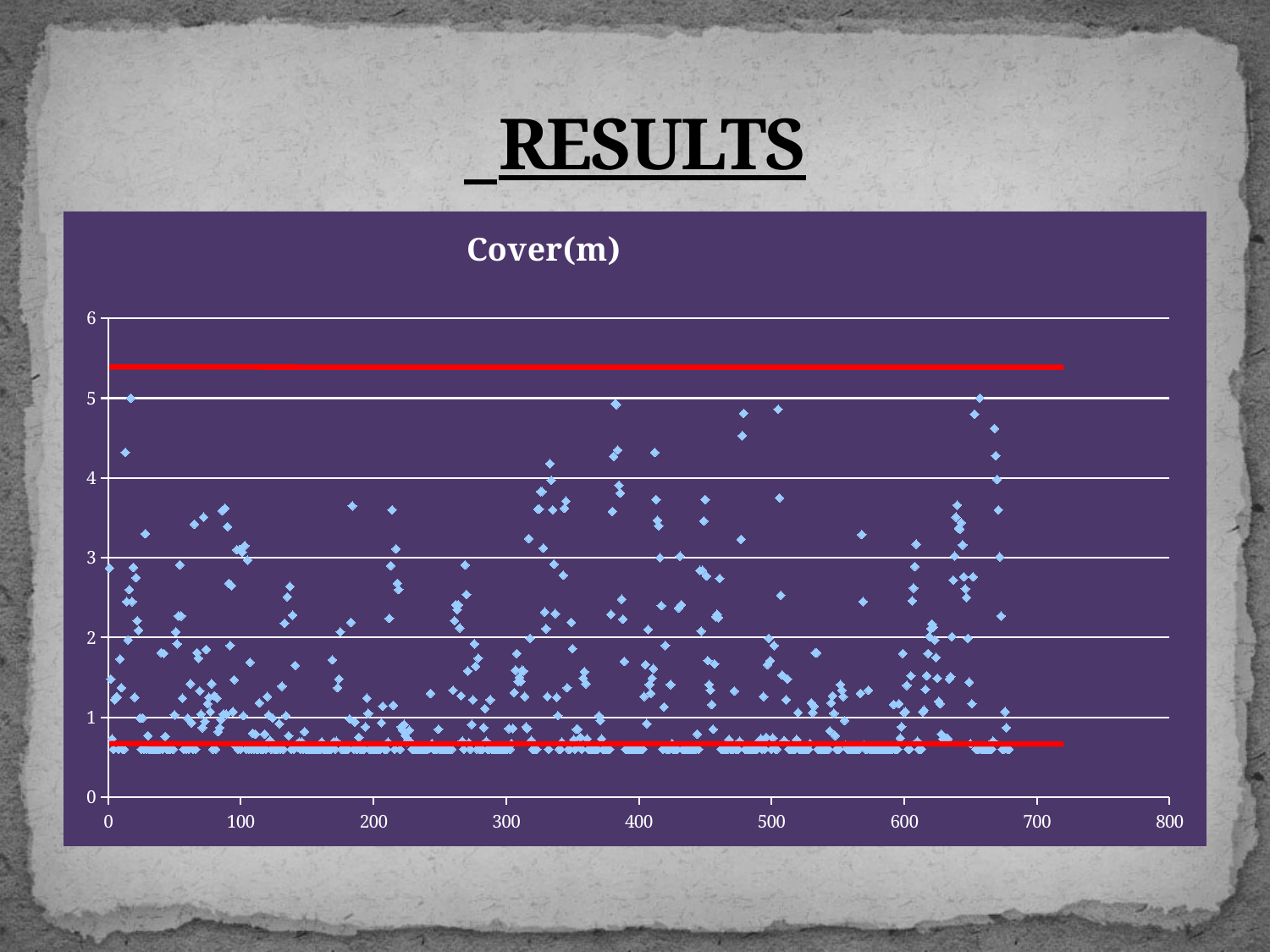
Which is higher on the chart, the upper red line or the highest plotted point? the upper red line Is the highest plotted point on the chart greater or less than 4? greater What kind of chart is shown on the slide? scatter chart How many red horizontal lines are drawn on the chart? 2 What is the title of the chart? Cover(m) Is the lowest plotted point on the chart greater or less than 1? less Is the value of the lower red horizontal line greater or less than 1? less